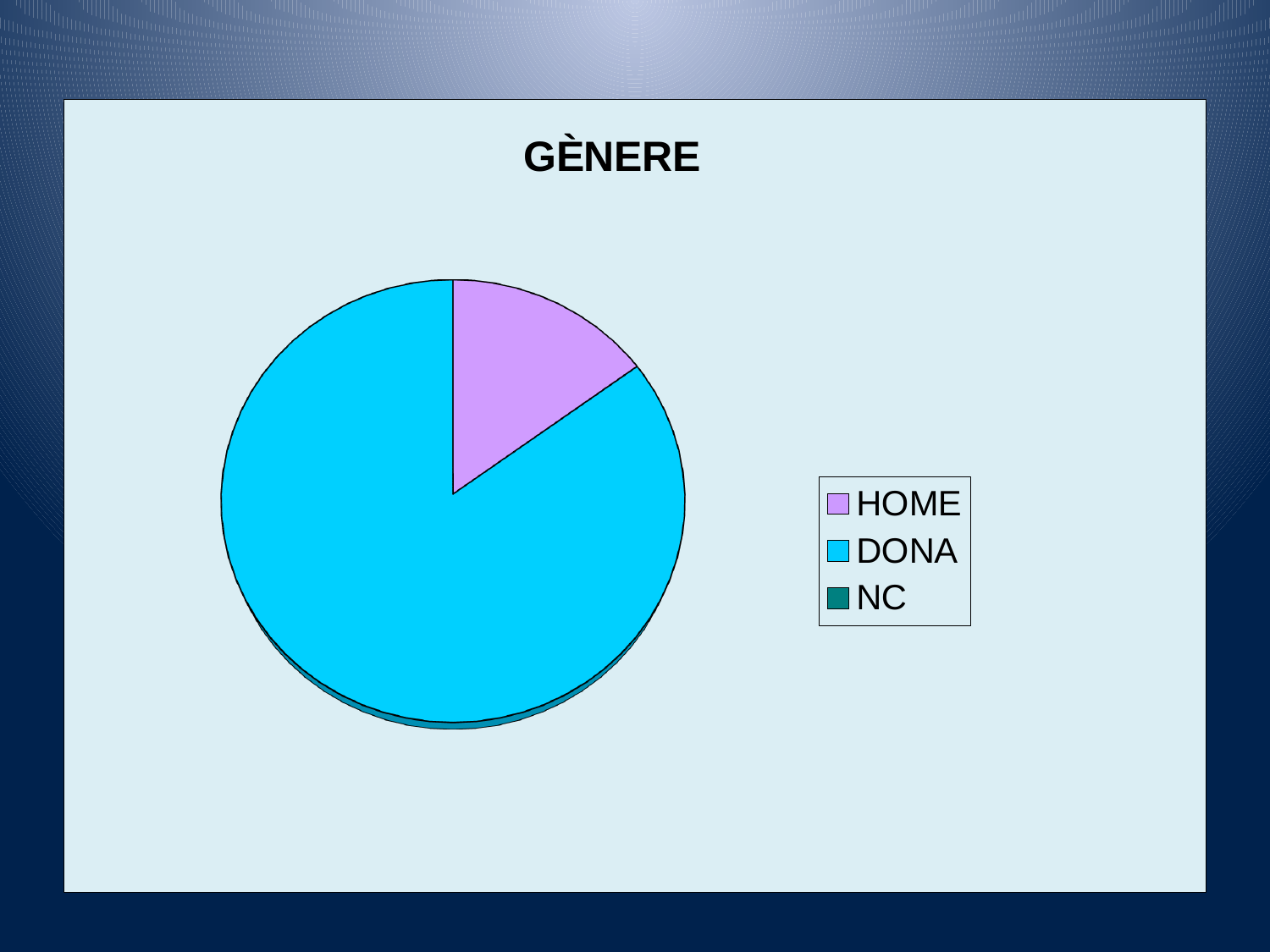
Which category has the largest slice of the pie? DONA What is the title of the chart? GÈNERE Which is larger, the slice for HOME or the slice for DONA? DONA How many entries does the chart's legend list? 3 What kind of chart is shown on the slide? pie chart What colour is the DONA slice in the pie chart? light blue